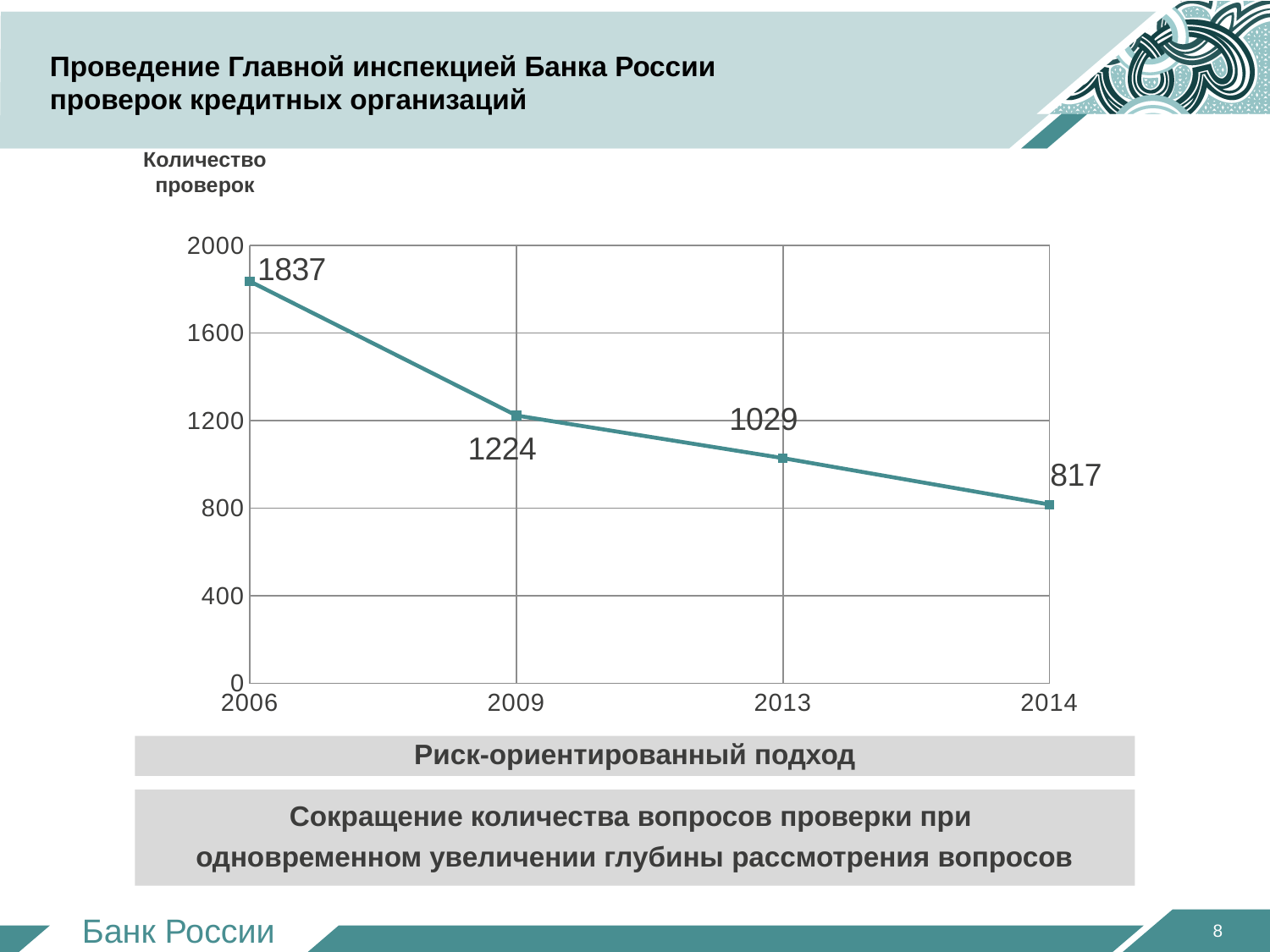
Which year had the lowest number of inspections? 2014 What type of chart is shown on the slide? Line chart What was the number of inspections (Количество проверок) in 2006? 1837 What was the number of inspections in 2013? 1029 By how much did the number of inspections fall from 2006 to 2014? 1020 Which year had the highest number of inspections? 2006 Is the number of inspections in 2014 greater or less than 1200? less What is the difference in the number of inspections between 2009 and 2013? 195 What was the number of inspections in 2014? 817 Which year had more inspections, 2009 or 2013? 2009 How many years are plotted on the chart? 4 What was the number of inspections in 2009? 1224